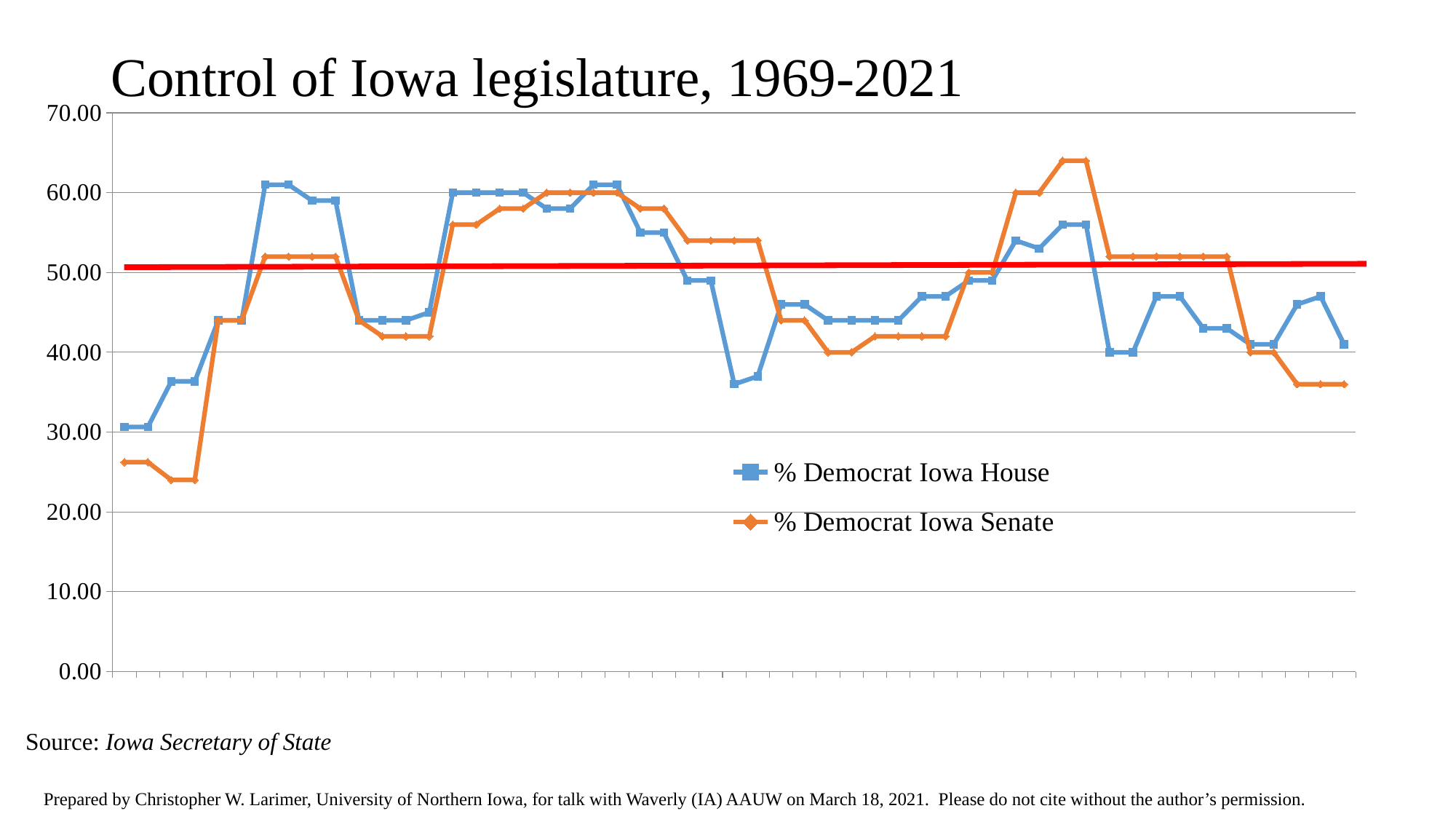
At the leftmost point of the chart, which series is higher, % Democrat Iowa House or % Democrat Iowa Senate? % Democrat Iowa House What kind of chart is shown on the slide? line chart Which series has the lowest point on the chart, % Democrat Iowa House or % Democrat Iowa Senate? % Democrat Iowa Senate Is the lowest value of the % Democrat Iowa Senate series greater or less than 30? less How many series does the legend list? 2 At the rightmost point of the chart, which series is higher, % Democrat Iowa House or % Democrat Iowa Senate? % Democrat Iowa House Which series is drawn in orange according to the legend? % Democrat Iowa Senate Which series reaches the highest peak on the chart, % Democrat Iowa House or % Democrat Iowa Senate? % Democrat Iowa Senate What is the title of the chart? Control of Iowa legislature, 1969-2021 Is the lowest value of the % Democrat Iowa House series greater or less than 40? less Is the highest value of the % Democrat Iowa Senate series greater or less than 60? greater Does the % Democrat Iowa Senate series end higher or lower than it starts at the left of the chart? higher